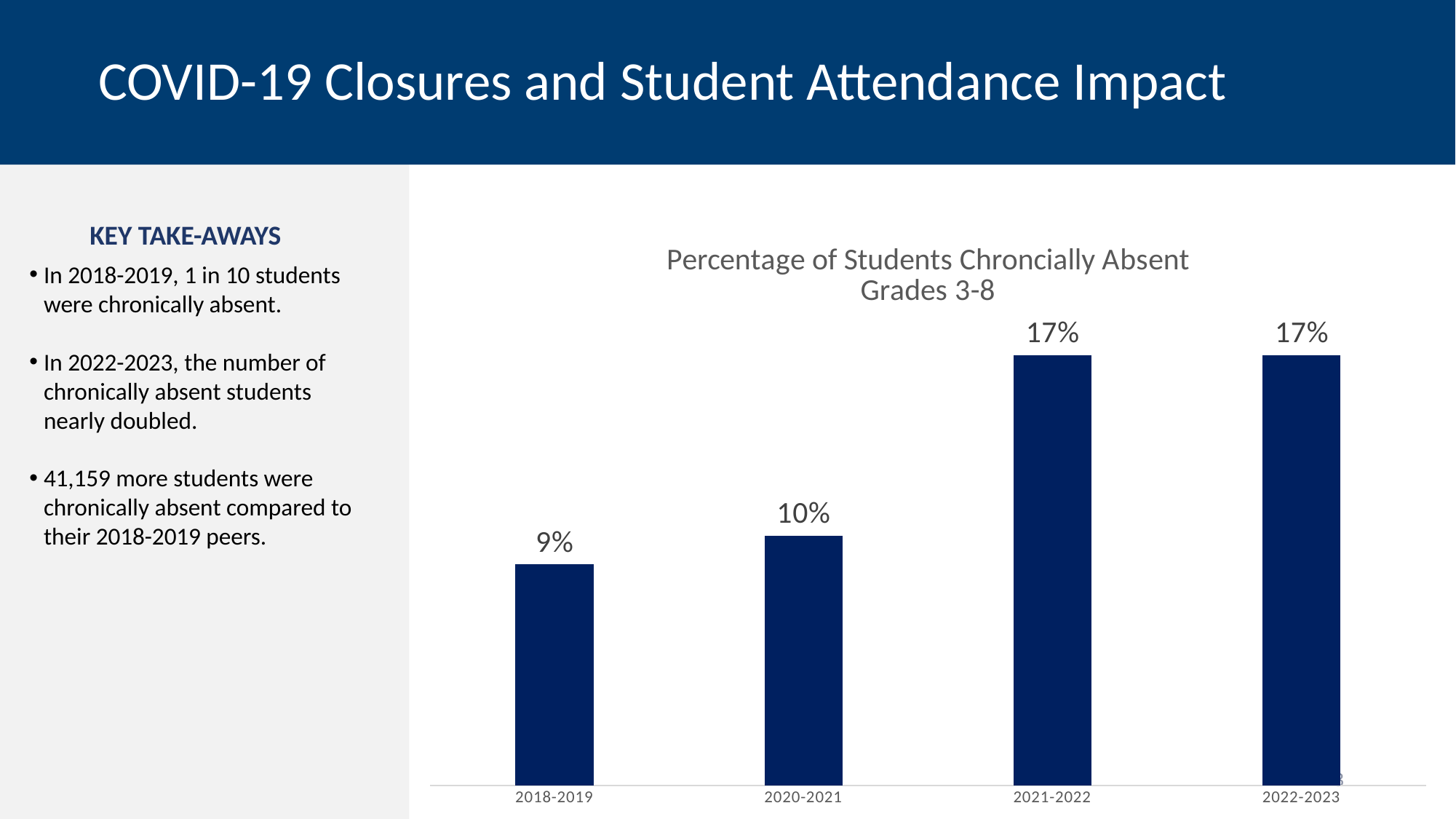
Do the values generally rise or fall from 2018-2019 to 2022-2023? Rise What percentage of students were chronically absent in 2018-2019? 9% Which school year has the lowest percentage of chronically absent students? 2018-2019 How many school years are shown in the chart? 4 What is the difference in the percentage of chronically absent students between 2022-2023 and 2018-2019? 8% What percentage of students were chronically absent in 2021-2022? 17% Which is larger, the percentage for 2021-2022 or the percentage for 2020-2021? 2021-2022 What percentage of students were chronically absent in 2020-2021? 10% What is the difference in the percentage of chronically absent students between 2020-2021 and 2018-2019? 1% What percentage of students were chronically absent in 2022-2023? 17% What kind of chart is shown on the slide? Bar chart What is the title of the chart? Percentage of Students Chroncially Absent Grades 3-8